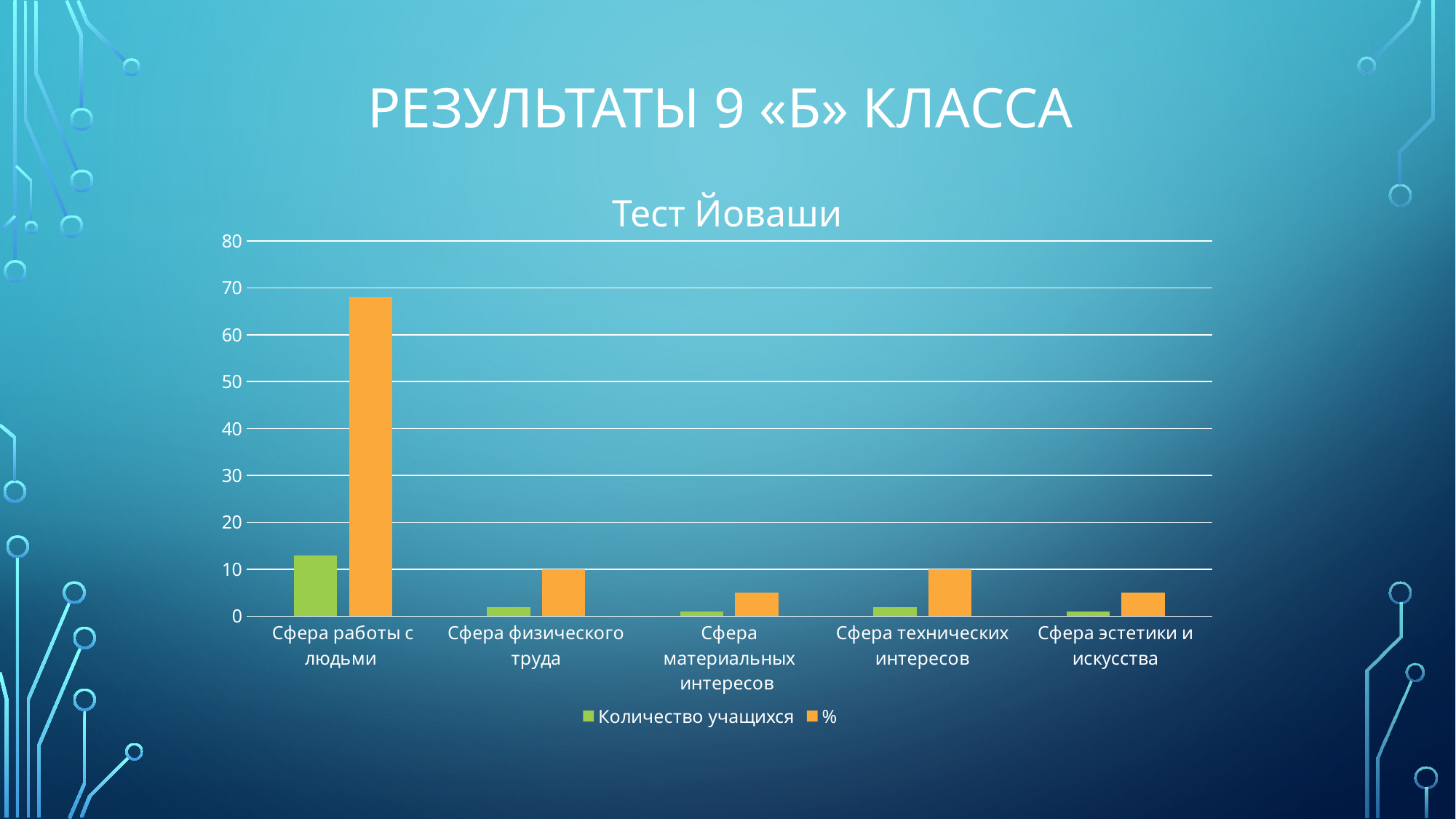
Is the % value for Сфера работы с людьми greater or less than 70? less Which category has the highest value for the % series? Сфера работы с людьми Which is larger: the % value for Сфера физического труда or the % value for Сфера эстетики и искусства? Сфера физического труда Which series is shown in orange in the legend? % What type of chart is shown on the slide? bar chart Is the % value for Сфера работы с людьми greater or less than 60? greater What is the title of the chart? Тест Йоваши Is the Количество учащихся value for Сфера работы с людьми greater or less than 10? greater How many categories are shown on the x axis? 5 Which category has the highest value for Количество учащихся? Сфера работы с людьми How many series does the legend list? 2